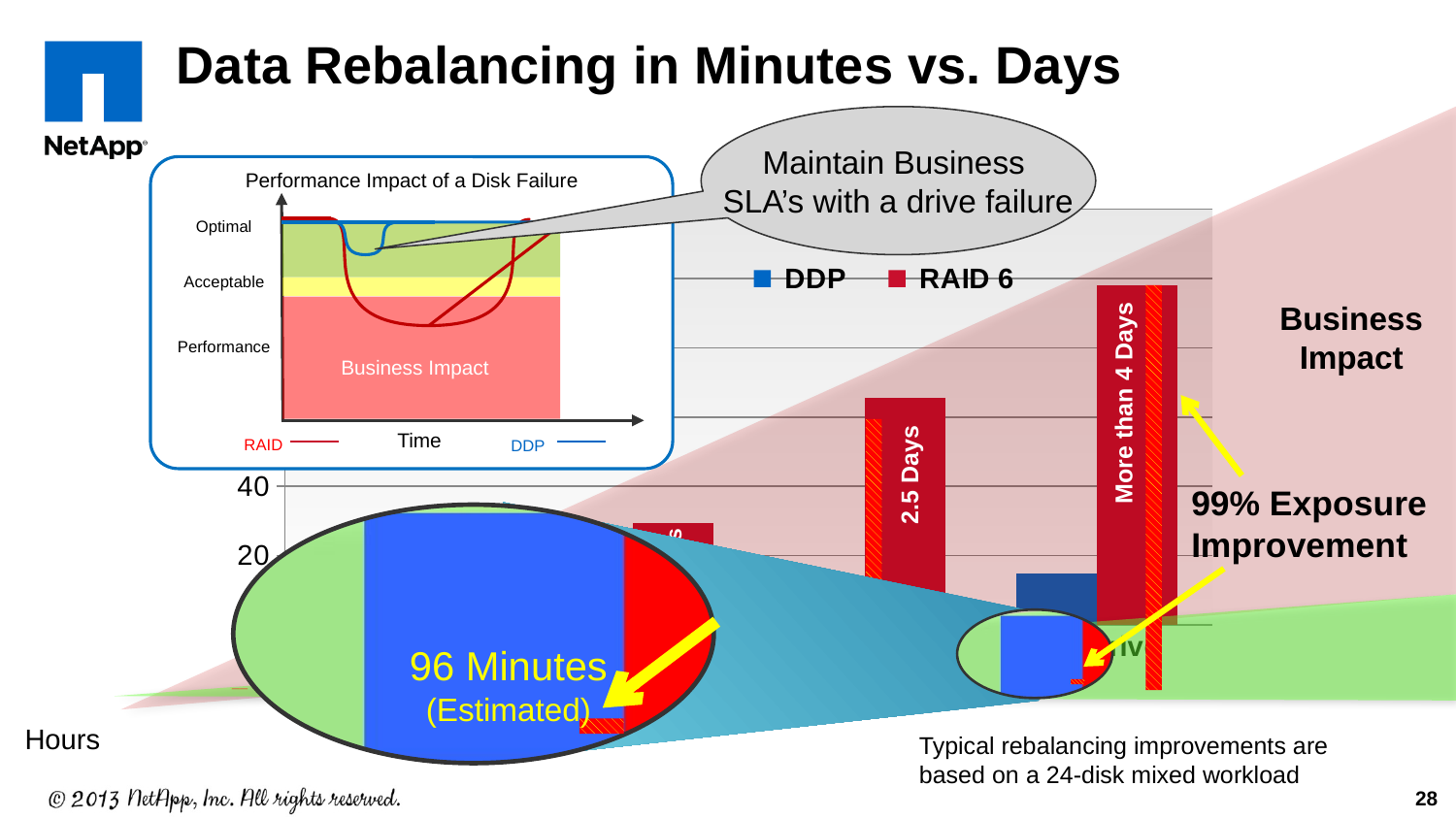
In the inset 'Performance Impact of a Disk Failure' chart, which series drops further below the Acceptable level after the disk failure, RAID or DDP? RAID In the main bar chart, what is the data label on the middle RAID 6 bar? 2.5 Days What is the x-axis label of the inset 'Performance Impact of a Disk Failure' chart? Time How many series does the inset 'Performance Impact of a Disk Failure' chart show? 2 In the main bar chart, which series has the taller bars, DDP or RAID 6? RAID 6 What kind of chart is the inset chart titled 'Performance Impact of a Disk Failure'? line chart What kind of chart is the main chart with the DDP and RAID 6 legend? bar chart In the main bar chart, what is the data label on the tallest RAID 6 bar? More than 4 Days What are the two series named in the legend of the main bar chart? DDP and RAID 6 In the main bar chart, is the RAID 6 bar labelled '2.5 Days' greater or less than 40 hours? greater How many series does the legend of the main bar chart list? 2 In the main bar chart, what estimated rebalancing time is shown in the magnified callout for DDP? 96 Minutes (Estimated)